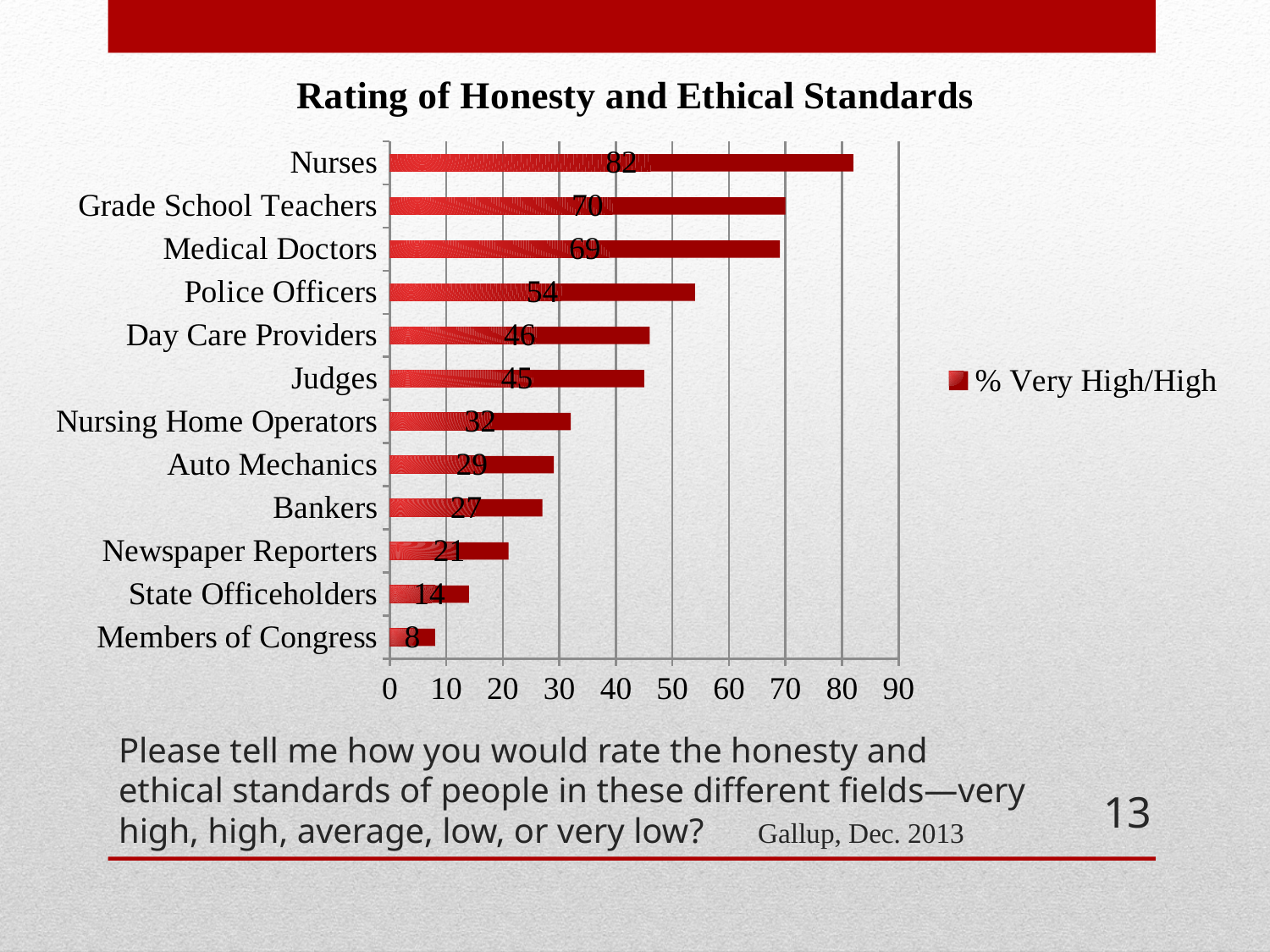
Which category has the lowest % Very High/High rating? Members of Congress What is the difference between the values for Police Officers and Judges? 9 What is the % Very High/High value for Nurses? 82 Is the value for Nursing Home Operators greater or less than 40? less What is the % Very High/High value for Bankers? 27 What is the % Very High/High value for State Officeholders? 14 How many categories are shown in the chart? 12 Which has a higher value, Grade School Teachers or Day Care Providers? Grade School Teachers Which category has the highest % Very High/High rating? Nurses What is the title of the chart? Rating of Honesty and Ethical Standards What type of chart is shown on the slide? Bar chart What is the difference between the values for Nurses and Members of Congress? 74